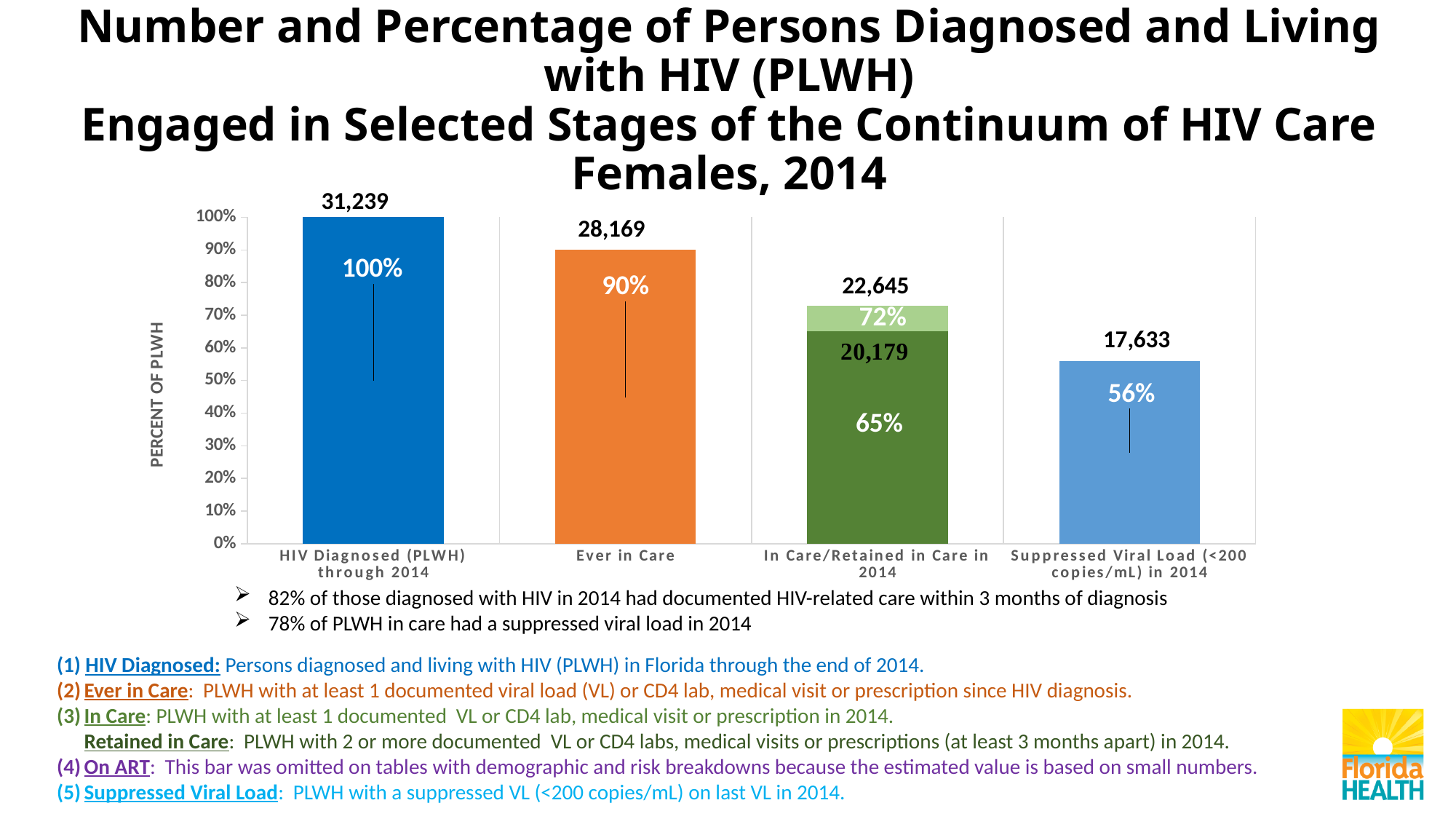
Which category has the lowest percentage of PLWH? Suppressed Viral Load (<200 copies/mL) in 2014 What is the difference in number of persons between 'HIV Diagnosed (PLWH) through 2014' and 'Ever in Care'? 3,070 What percentage is shown for the dark green 'Retained in Care' portion of the bar? 65% How many categories are shown on the x axis of the chart? 4 What is the number of persons shown for the 'Ever in Care' bar? 28,169 What is the label on the vertical axis of the chart? PERCENT OF PLWH What number is shown at the top of the 'In Care/Retained in Care in 2014' bar? 22,645 Which is larger: the percentage for 'Ever in Care' or the percentage for 'In Care/Retained in Care in 2014'? Ever in Care What kind of chart is shown on the slide? bar chart What is the number of persons shown for 'HIV Diagnosed (PLWH) through 2014'? 31,239 What percentage of PLWH is shown for 'Suppressed Viral Load (<200 copies/mL) in 2014'? 56% Which category has the highest number of persons? HIV Diagnosed (PLWH) through 2014